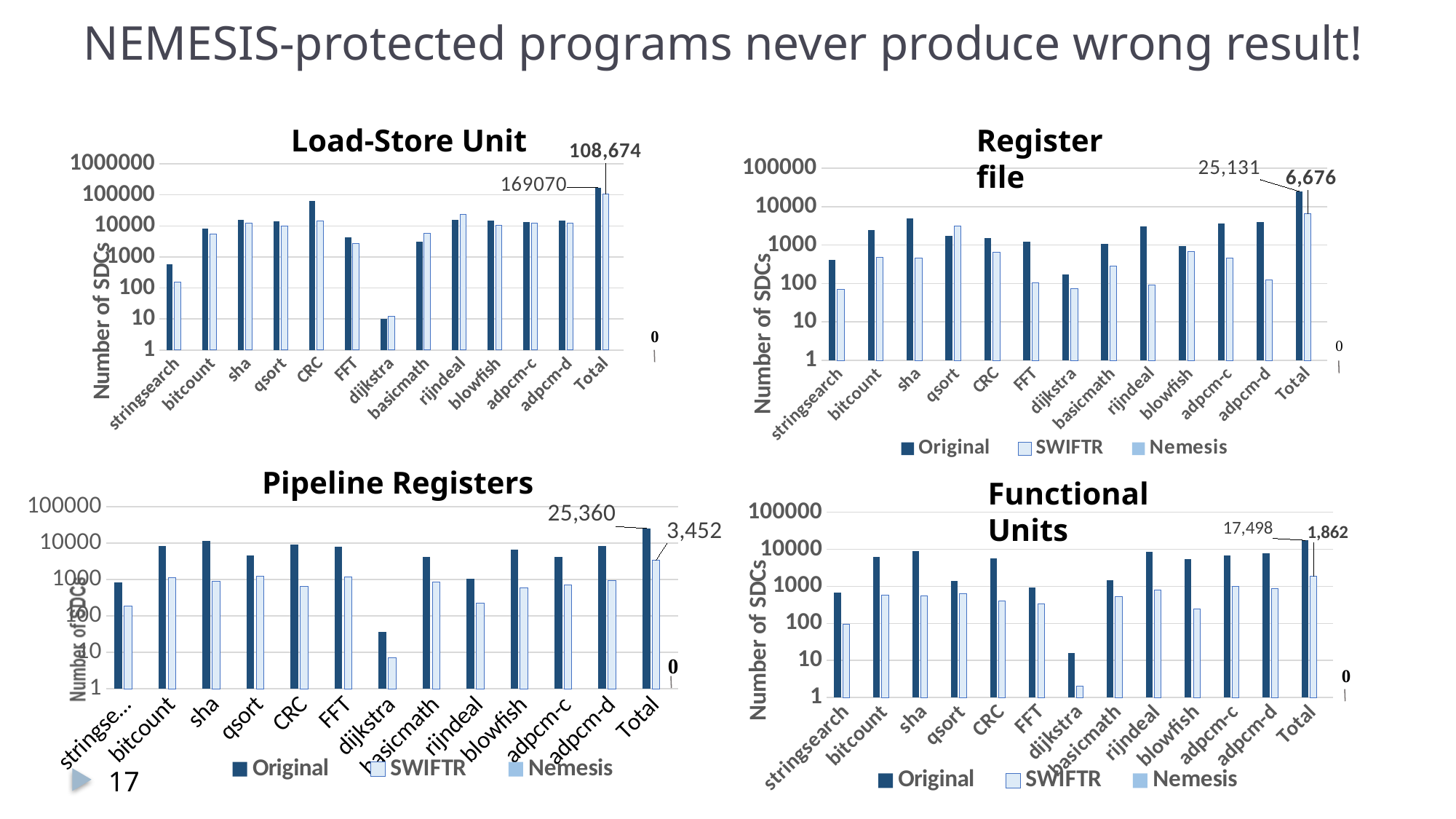
In the Load-Store Unit chart, what is the SWIFTR value for Total? 108,674 In the Load-Store Unit chart, which category has the lowest Original value? dijkstra What kind of chart is the Load-Store Unit chart? bar chart In the Load-Store Unit chart, is the Original value for dijkstra greater or less than 100? less In the Load-Store Unit chart, what is the Original value for Total? 169070 In the Pipeline Registers chart, what is the Nemesis value for Total? 0 In the Register file chart, is the Original value for sha greater or less than 1000? greater How many series does the legend of the Register file chart list? 3 In the Register file chart, what is the SWIFTR value for Total? 6,676 How many categories are shown on the x axis of the Functional Units chart? 13 In the Pipeline Registers chart, which is larger for Total: the Original value or the SWIFTR value? Original In the Functional Units chart, what is the difference between the Original and SWIFTR values for Total? 15,636